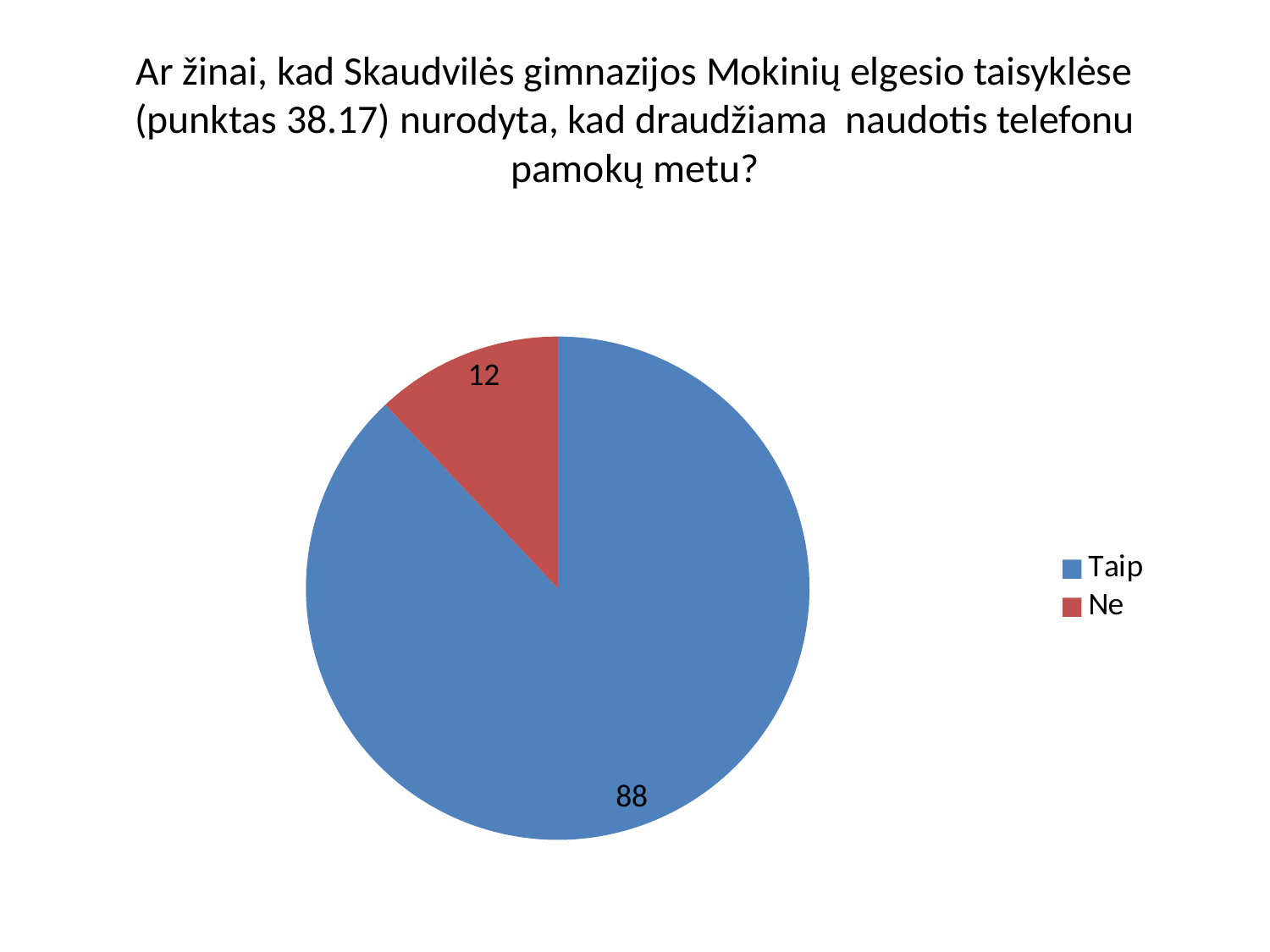
How many entries does the legend list? 2 What share of the pie does the Ne slice represent? 12% What is the value for Taip? 88 What is the difference between the values for Taip and Ne? 76 How many slices does the pie chart have? 2 What colour is the Taip slice? blue What kind of chart is shown on the slide? pie chart What is the value for Ne? 12 Which category has the largest slice? Taip Which is larger, the value for Taip or the value for Ne? Taip Which category has the smallest slice? Ne What is the total of the two slice values? 100